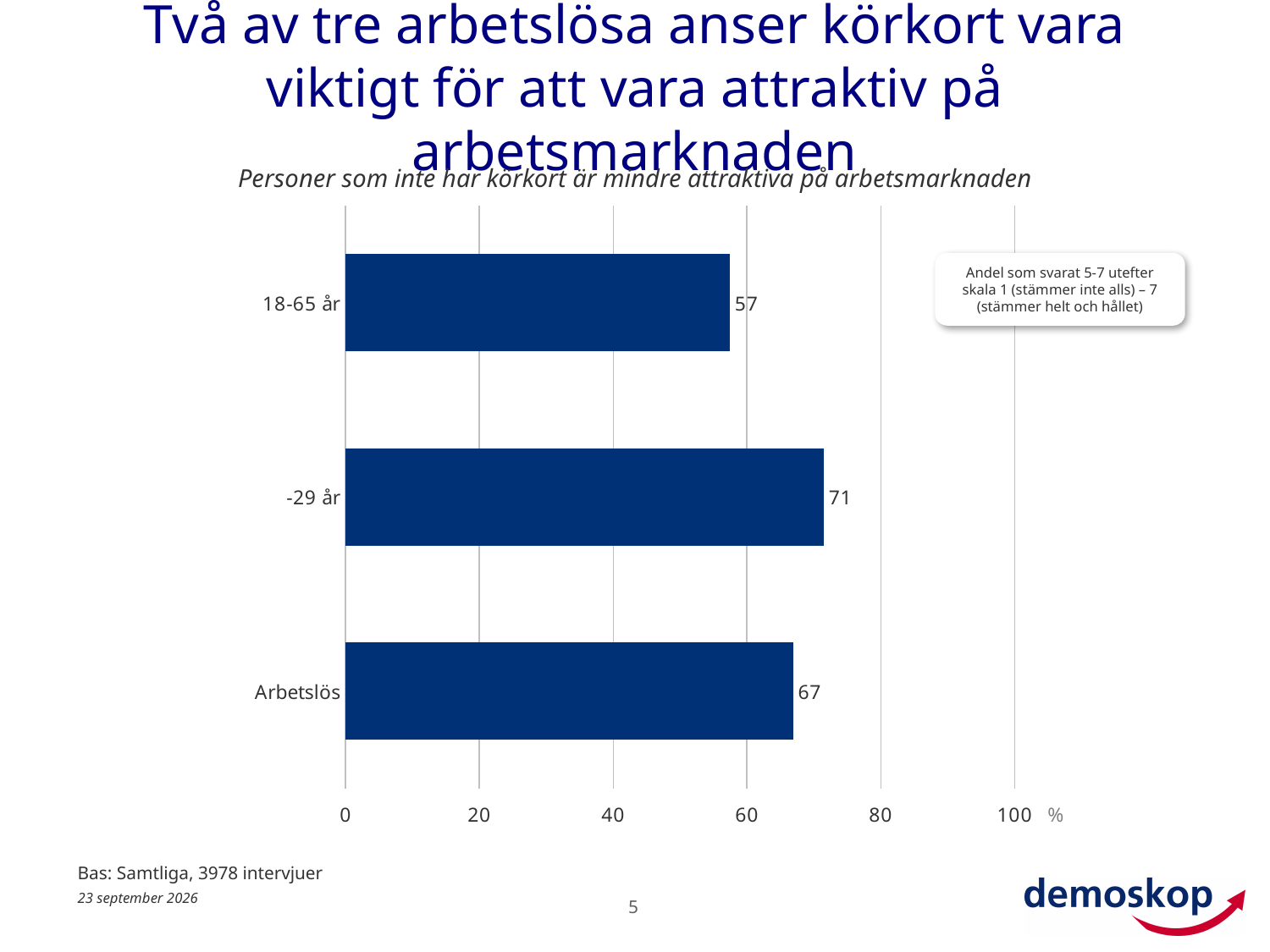
What is the difference between the values for -29 år and Arbetslös? 4 Which category has the highest value? -29 år What is the value for 18-65 år? 57 Is the value for Arbetslös greater or less than 60? greater What is the value for Arbetslös? 67 What is the chart's title? Personer som inte har körkort är mindre attraktiva på arbetsmarknaden What is the difference between the values for -29 år and 18-65 år? 14 Which category has the lowest value? 18-65 år What is the value for -29 år? 71 How many categories are shown in the chart? 3 Which is larger, the value for Arbetslös or the value for 18-65 år? Arbetslös What kind of chart is shown on the slide? bar chart